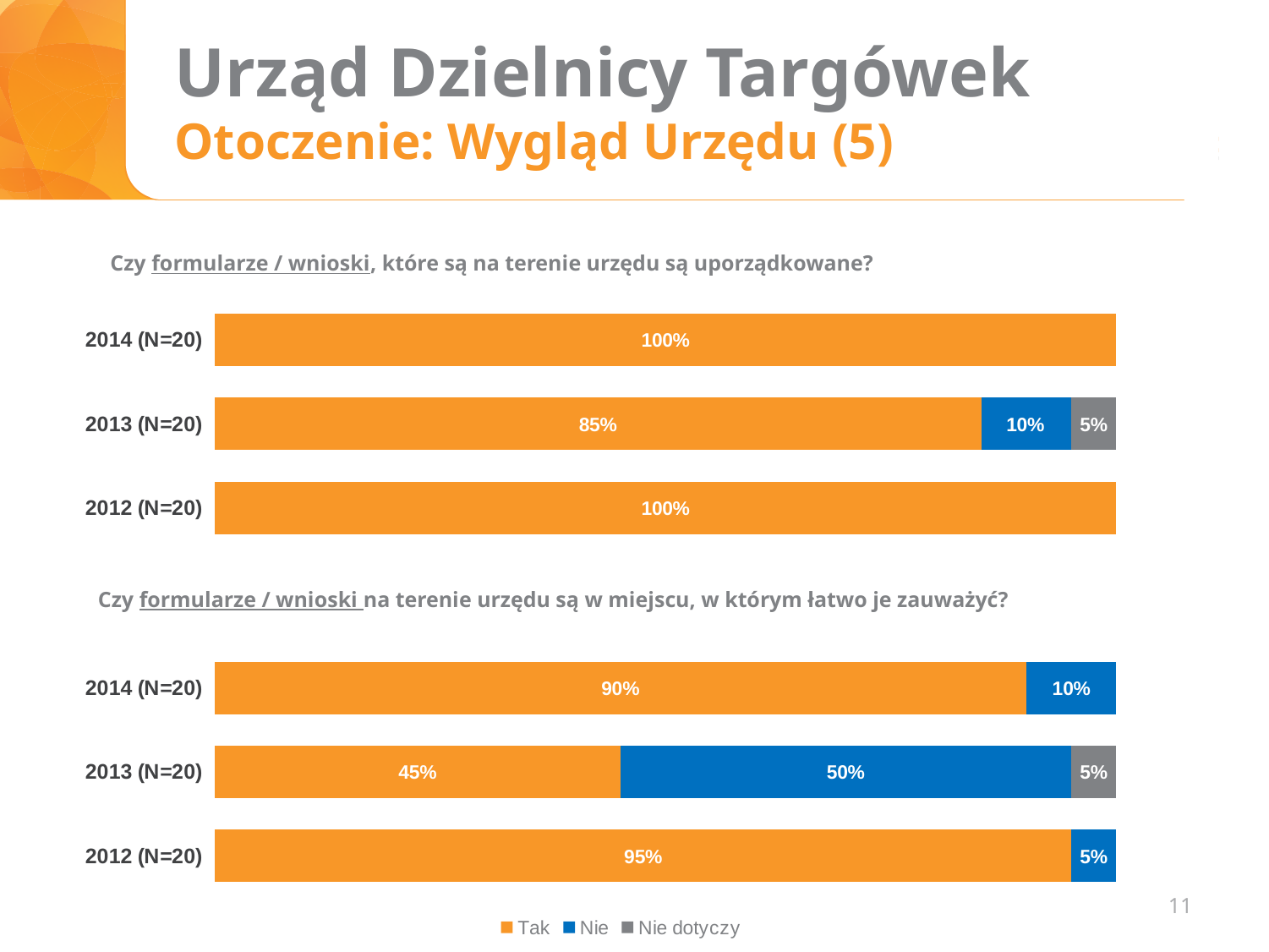
How many year categories are shown in the top chart? 3 In the top chart, what percentage answered "Tak" in 2014 (N=20)? 100% In the bottom chart, is the "Tak" share larger in 2012 or in 2014? 2012 In the bottom chart, what is the difference between the "Tak" share in 2014 and in 2013? 45% In the bottom chart, what percentage answered "Tak" in 2012 (N=20)? 95% How many series does the legend list? 3 What type of chart is used on this slide? Stacked bar chart In the top chart, what percentage answered "Tak" in 2013 (N=20)? 85% In the bottom chart, which year has the highest "Nie" share? 2013 (N=20) In the bottom chart, what percentage answered "Nie" in 2013 (N=20)? 50% In the bottom chart, which year has the lowest "Tak" share? 2013 (N=20) In the top chart, what percentage answered "Nie" in 2013 (N=20)? 10%